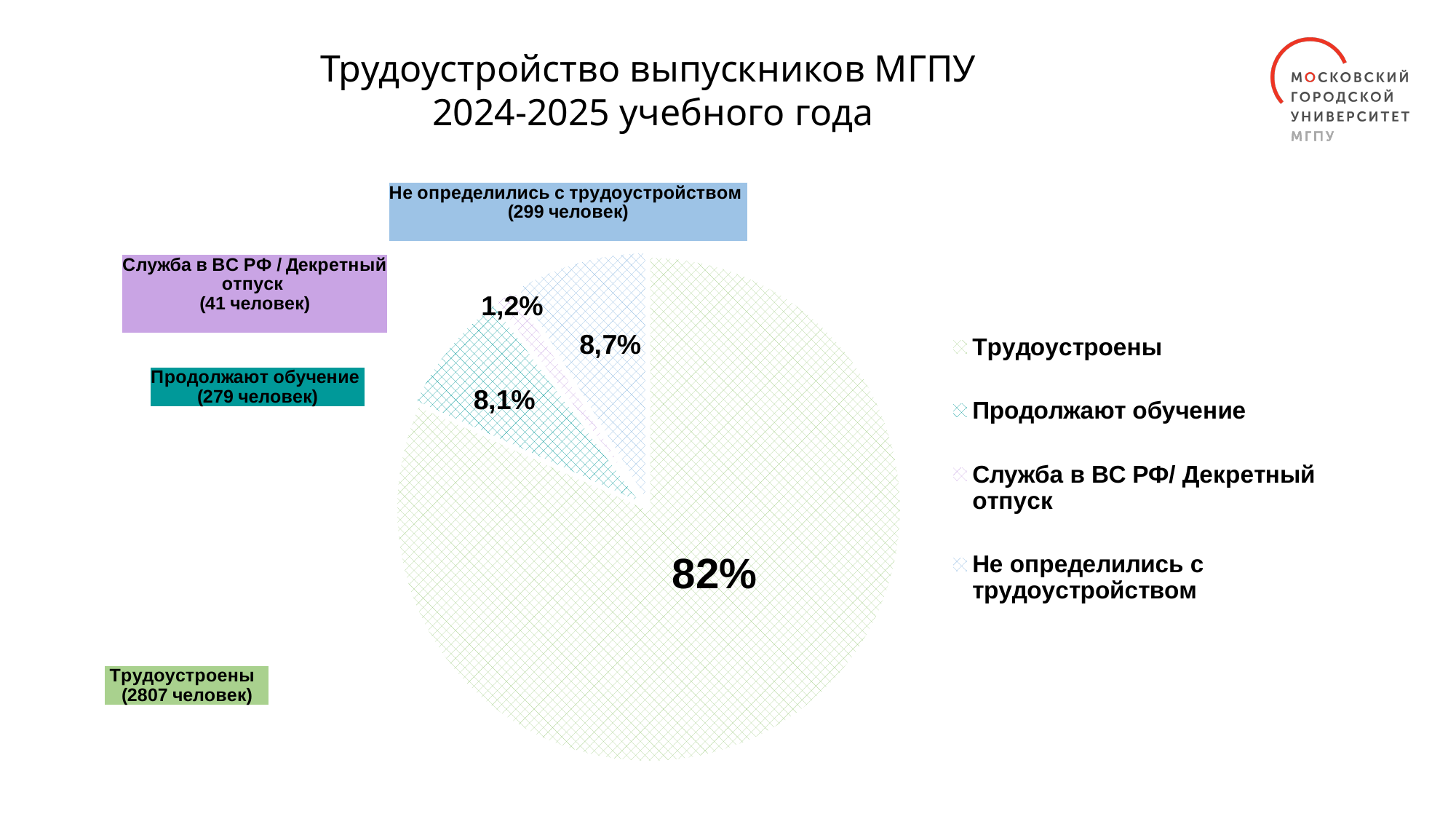
Which category has the smallest slice of the pie? Служба в ВС РФ/ Декретный отпуск What type of chart is shown on the slide? pie chart Which category has the largest slice of the pie? Трудоустроены How many people are in the "Трудоустроены" category according to the label on the slide? 2807 человек How many slices does the pie chart have? 4 What share of the pie does the "Не определились с трудоустройством" slice have? 8,7% What share of the pie does the "Продолжают обучение" slice have? 8,1% What is the difference in percentage points between the "Не определились с трудоустройством" slice and the "Продолжают обучение" slice? 0,6 How many people are in the "Продолжают обучение" category according to the label on the slide? 279 человек What share of the pie does the "Трудоустроены" slice have? 82% How many entries does the legend list? 4